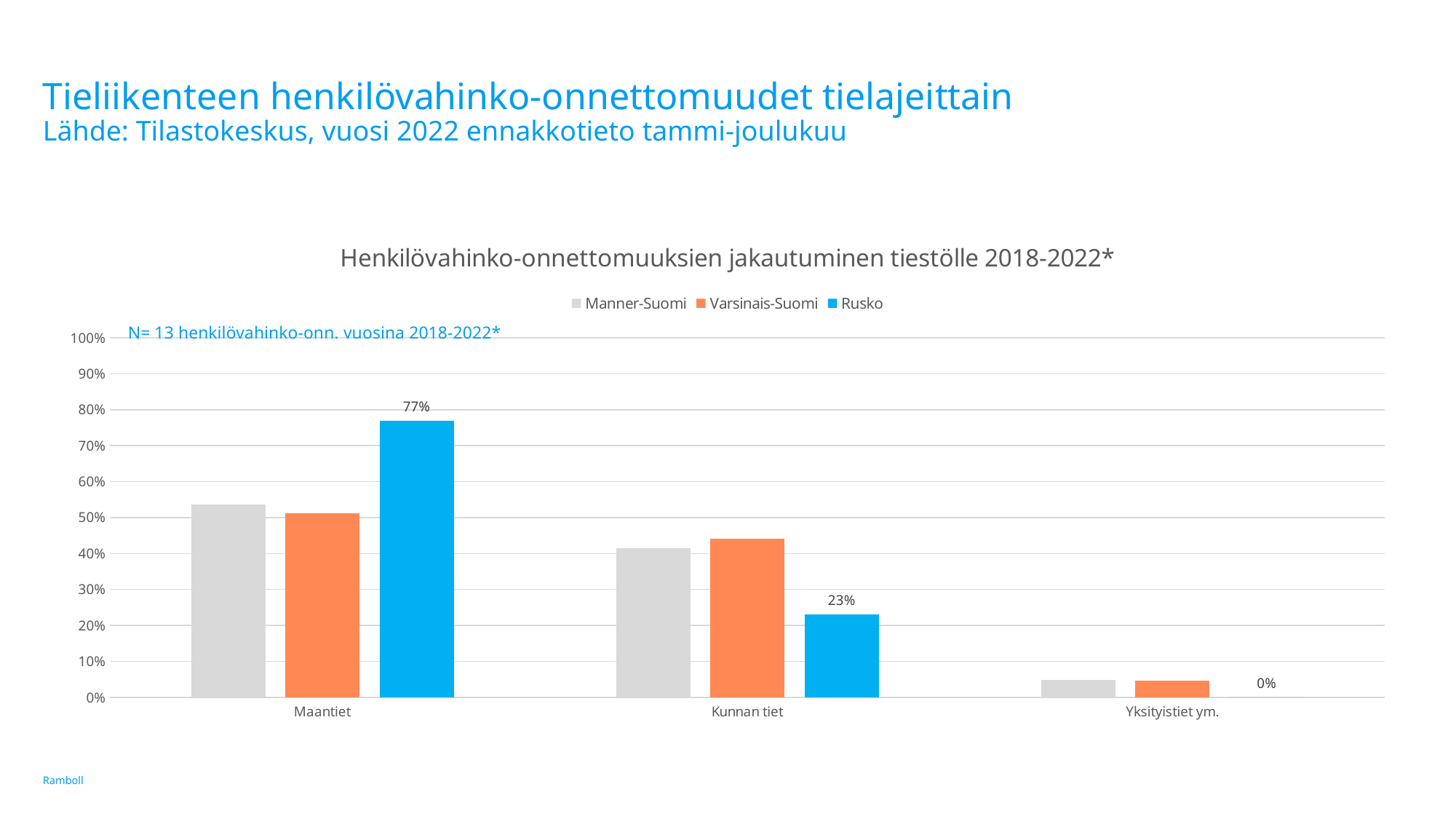
How many road-type categories are shown on the x axis? 3 What kind of chart is shown on the slide? Bar chart In the Kunnan tiet category, which is larger: Varsinais-Suomi or Rusko? Varsinais-Suomi In which category does the Rusko series have its lowest value? Yksityistiet ym. What is the value for Rusko in the Yksityistiet ym. category? 0% What is the value for Rusko in the Kunnan tiet category? 23% What is the difference between the Rusko values for Maantiet and Kunnan tiet? 54 percentage points How many series does the legend list? 3 Is the value for Manner-Suomi in the Yksityistiet ym. category greater or less than 10%? less In which category does the Rusko series have its highest value? Maantiet What is the value for Rusko in the Maantiet category? 77% Is the value for Manner-Suomi in the Kunnan tiet category greater or less than 50%? less